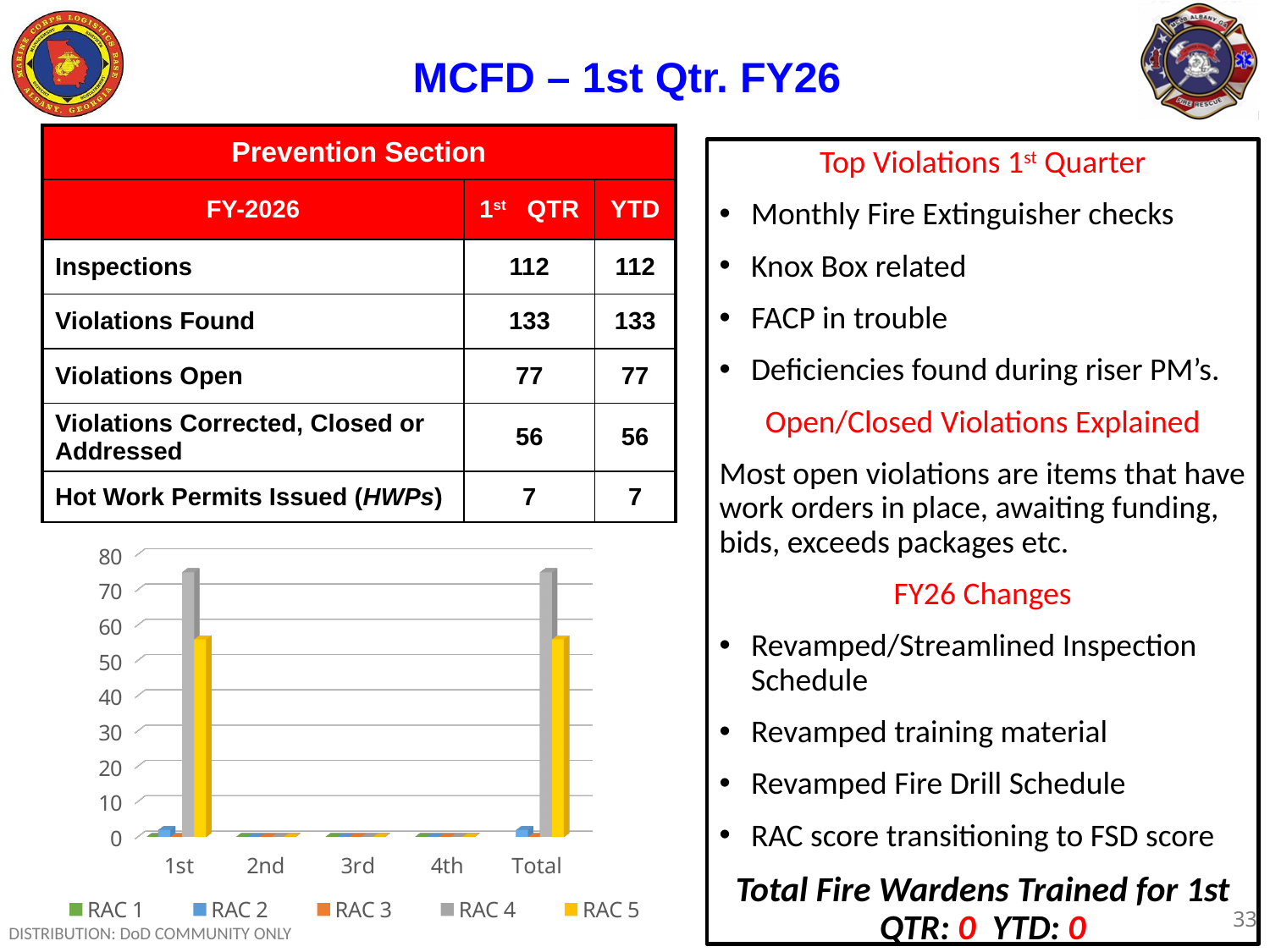
How many categories are shown on the x axis of the chart? 5 In the Total category, which is larger, RAC 2 or RAC 4? RAC 4 What colour represents RAC 5 in the chart legend? yellow Is the value for RAC 2 in the 1st category greater or less than 10? less Which series has the tallest bar in the 1st category? RAC 4 Is the value for RAC 5 in the Total category greater or less than 60? less Is the value for RAC 4 in the 1st category greater or less than 70? greater In the 1st category, which is larger, RAC 4 or RAC 5? RAC 4 What is the highest value shown on the chart's vertical axis? 80 How many series does the chart legend list? 5 What kind of chart is shown on the slide? bar chart